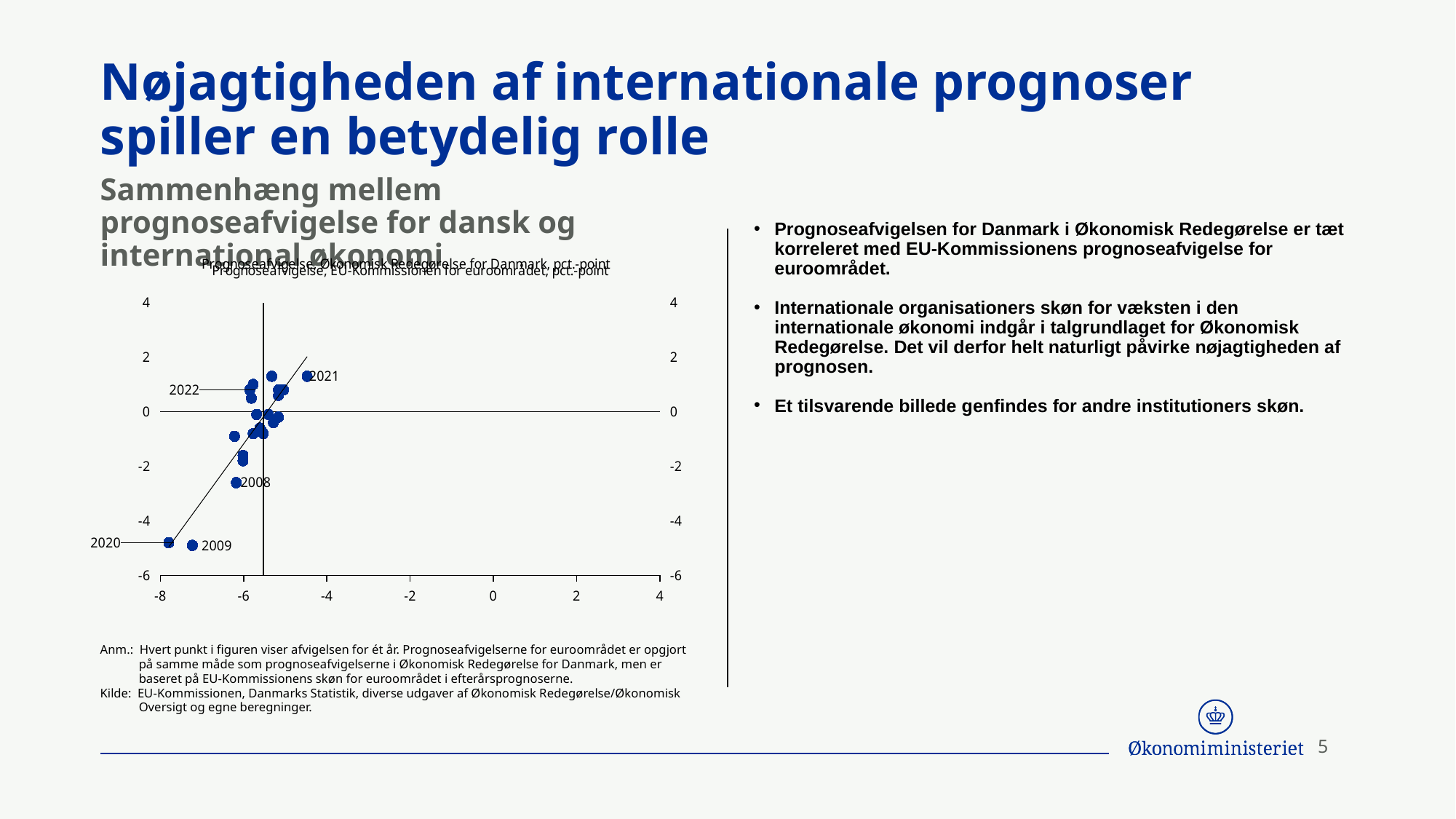
Is the vertical-axis value for the point labelled 2009 greater or less than -4? less What kind of chart is shown on the slide? Scatter chart Is the vertical-axis value for the point labelled 2008 greater or less than -2? less Is the vertical-axis value for the point labelled 2021 greater or less than 0? greater How many points in the chart are labelled with a year? 5 Do the plotted points generally rise or fall as you move from left to right along the horizontal axis? Rise Which labelled point lies higher on the vertical axis, 2021 or 2008? 2021 What is the title of the chart? Sammenhæng mellem prognoseafvigelse for dansk og international økonomi Which labelled point lies further to the left on the horizontal axis, 2020 or 2009? 2020 Which of the labelled points has the lowest vertical-axis value? 2009